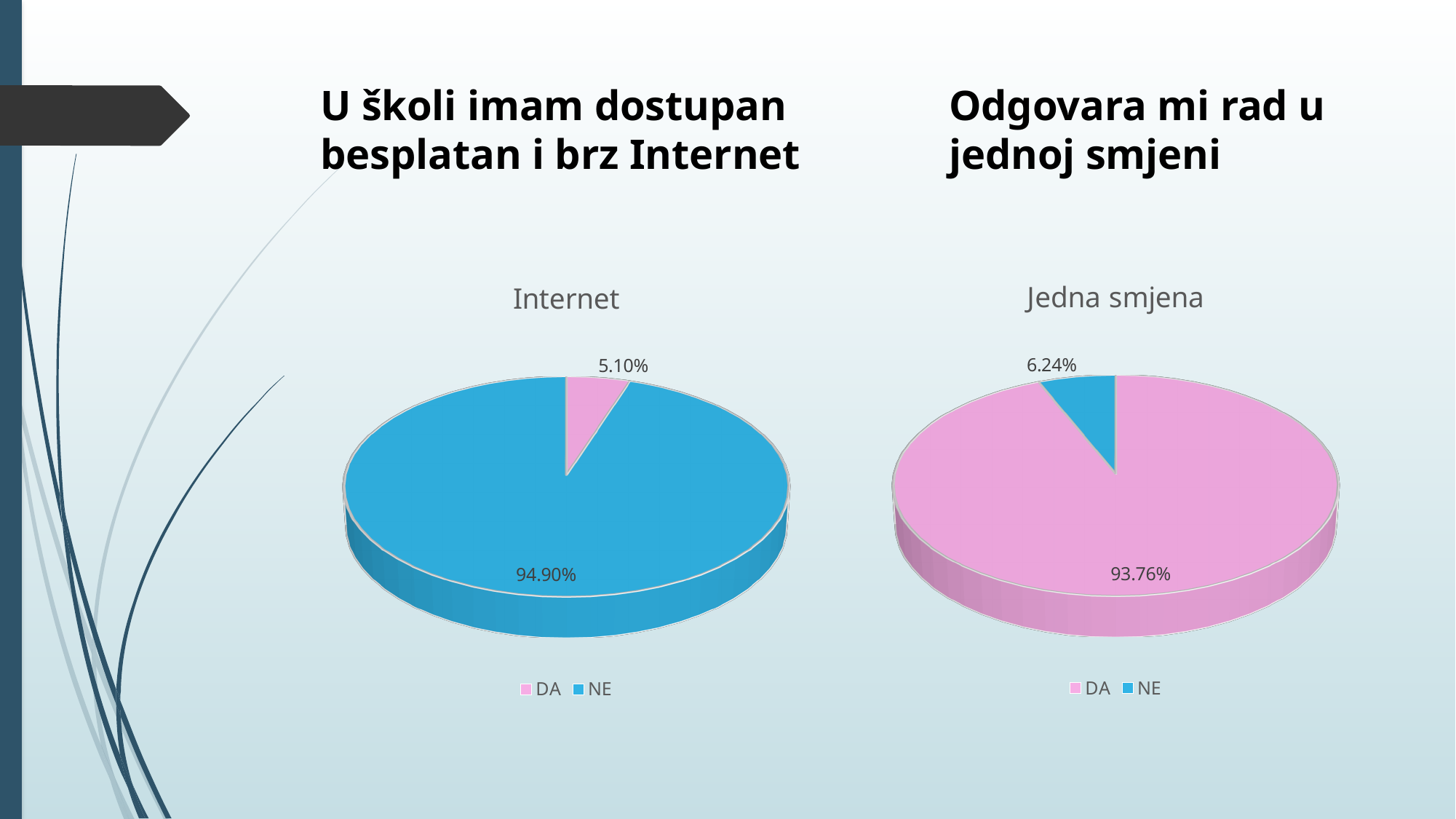
In the "Internet" pie chart, which category has the largest slice? NE In the "Jedna smjena" pie chart, what share does DA have? 93.76% In the "Internet" pie chart, what is the difference between the NE and DA shares? 89.80% How many entries does the legend of the "Internet" chart list? 2 How many slices does the "Internet" pie chart have? 2 In the "Internet" pie chart, what share does DA have? 5.10% In the "Jedna smjena" pie chart, what colour is the DA slice? Pink In the "Jedna smjena" pie chart, what share does NE have? 6.24% In the "Jedna smjena" pie chart, which is larger, DA or NE? DA In the "Jedna smjena" pie chart, which category has the smallest slice? NE In the "Internet" pie chart, what share does NE have? 94.90% What type of chart is the "Jedna smjena" chart? Pie chart